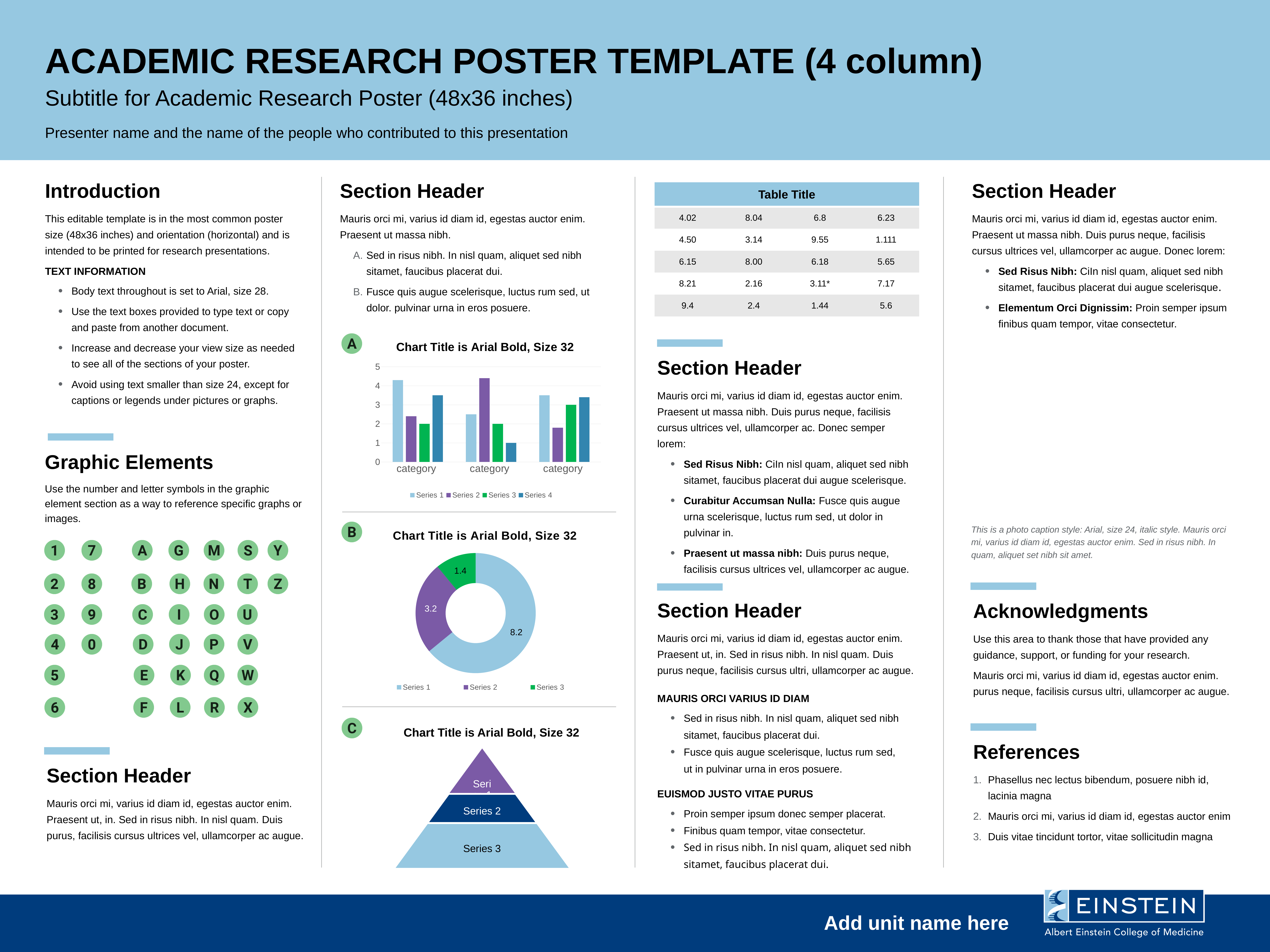
In chart A, is the Series 2 bar in the middle category group greater or less than 4? greater What type of chart is chart B (the middle chart in the second column)? doughnut chart In chart A, which series has the tallest bar in the middle category group? Series 2 How many category groups are plotted along the x axis of chart A? 3 In chart A, is the Series 4 bar in the middle category group greater or less than 2? less In chart A, which series has the shortest bar in the middle category group? Series 4 How many series does the legend of chart A list? 4 In chart B, what is the value shown for Series 3? 1.4 In chart B, which series has the smallest slice? Series 3 In chart B, what is the value shown for Series 1? 8.2 What type of chart is chart A (the top chart in the second column)? bar chart In chart B, what is the difference between the Series 1 value and the Series 2 value? 5.0